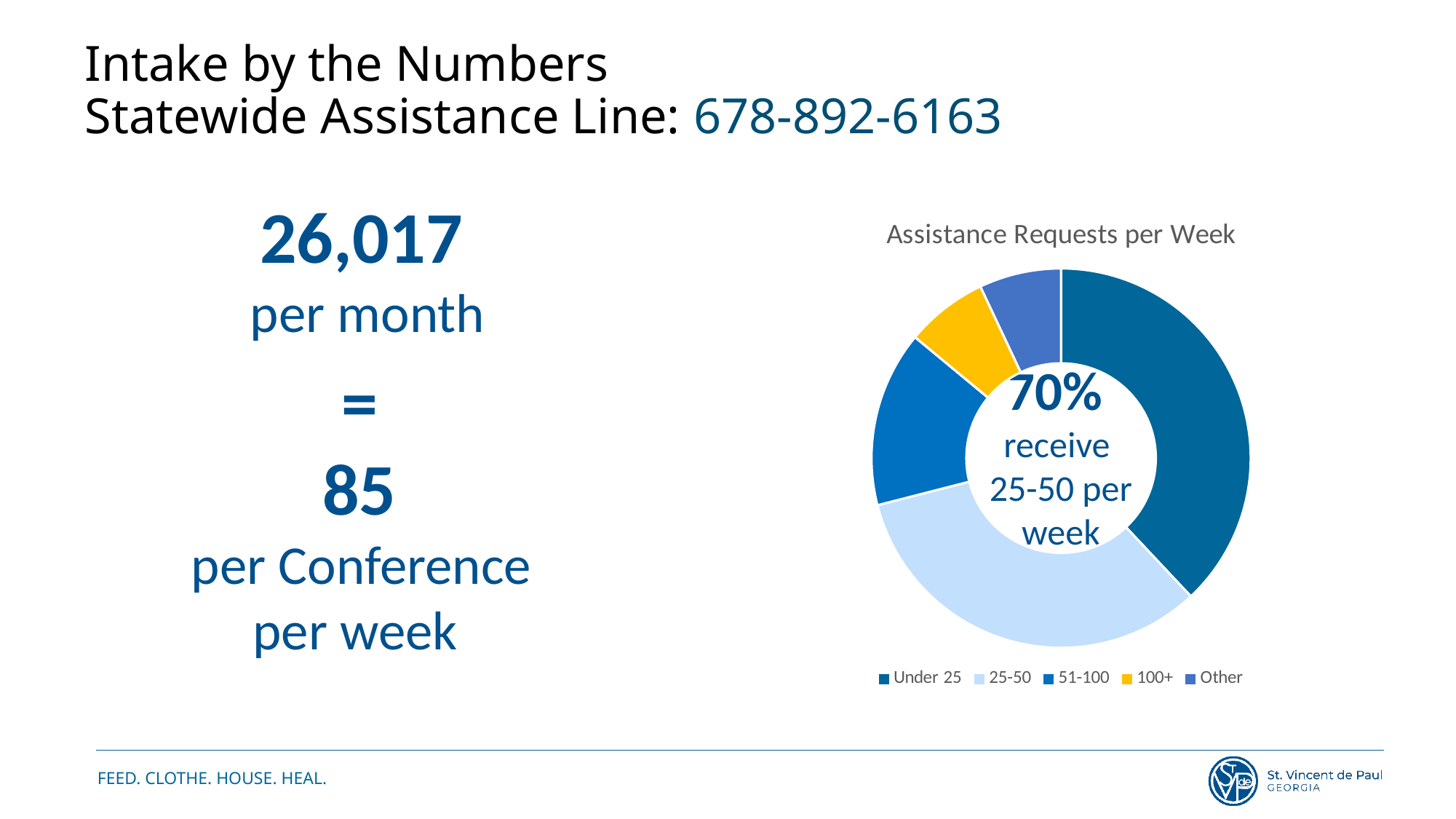
Which category has the largest slice in the chart? Under 25 Which slice is larger, 51-100 or 100+? 51-100 Which slice is larger, 25-50 or 51-100? 25-50 How many data series does the chart show? 1 What is the title of the chart? Assistance Requests per Week What colour represents the 100+ category in the chart? Yellow What kind of chart is shown on the slide? Doughnut (pie) chart How many categories does the chart's legend list? 5 Which slice is larger, 25-50 or Other? 25-50 What percentage is printed in the centre of the doughnut chart? 70%